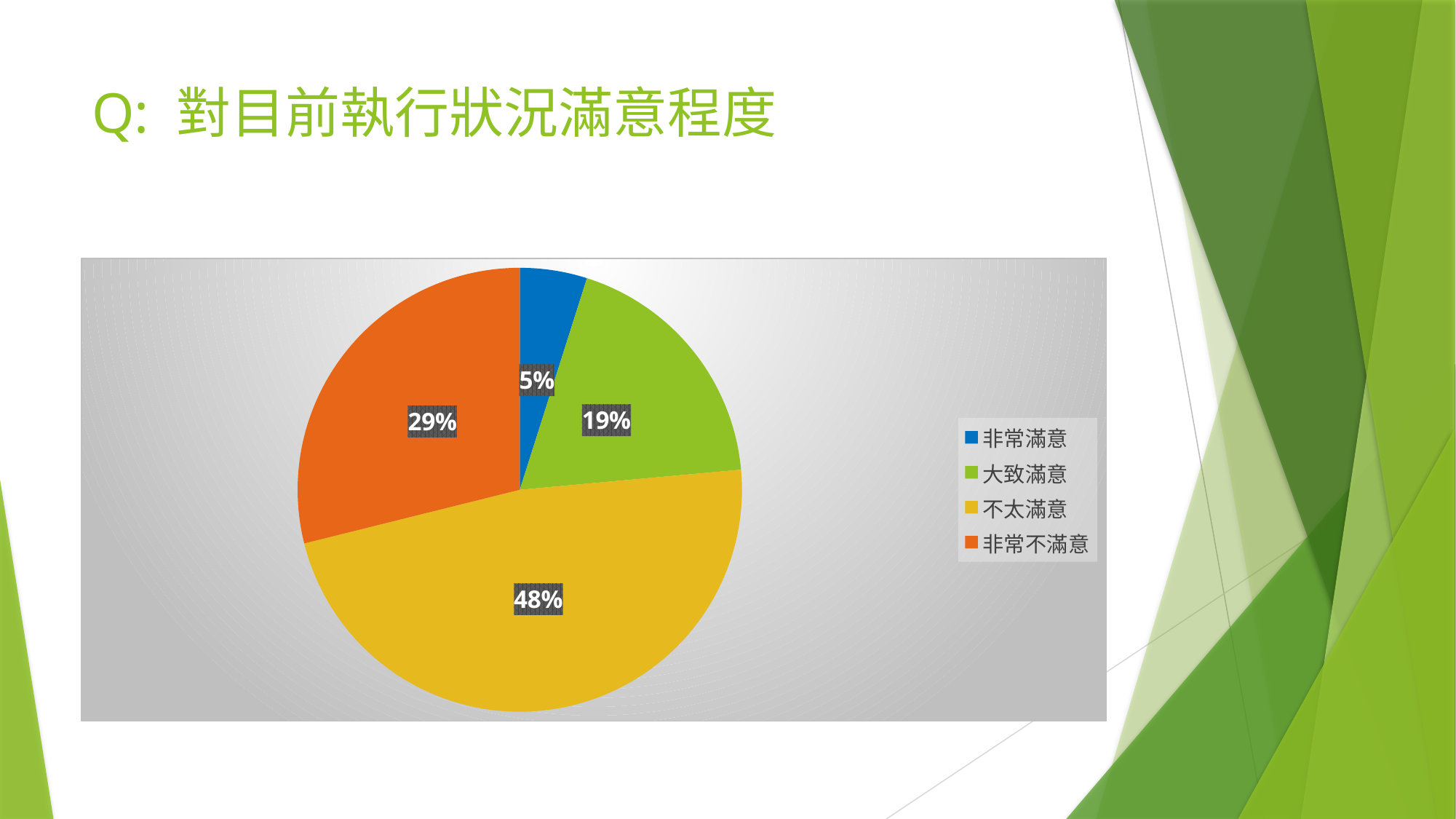
What share of the pie does 非常滿意 have? 5% What kind of chart is shown on the slide? pie chart What share of the pie does 大致滿意 have? 19% What is the difference between the shares of 大致滿意 and 非常滿意? 14% What colour is the slice for 非常滿意? blue What share of the pie does 非常不滿意 have? 29% Which is larger, the share of 非常不滿意 or the share of 大致滿意? 非常不滿意 Which category has the smallest slice of the pie? 非常滿意 What is the difference between the shares of 不太滿意 and 非常不滿意? 19% How many categories does the legend list? 4 Which category has the largest slice of the pie? 不太滿意